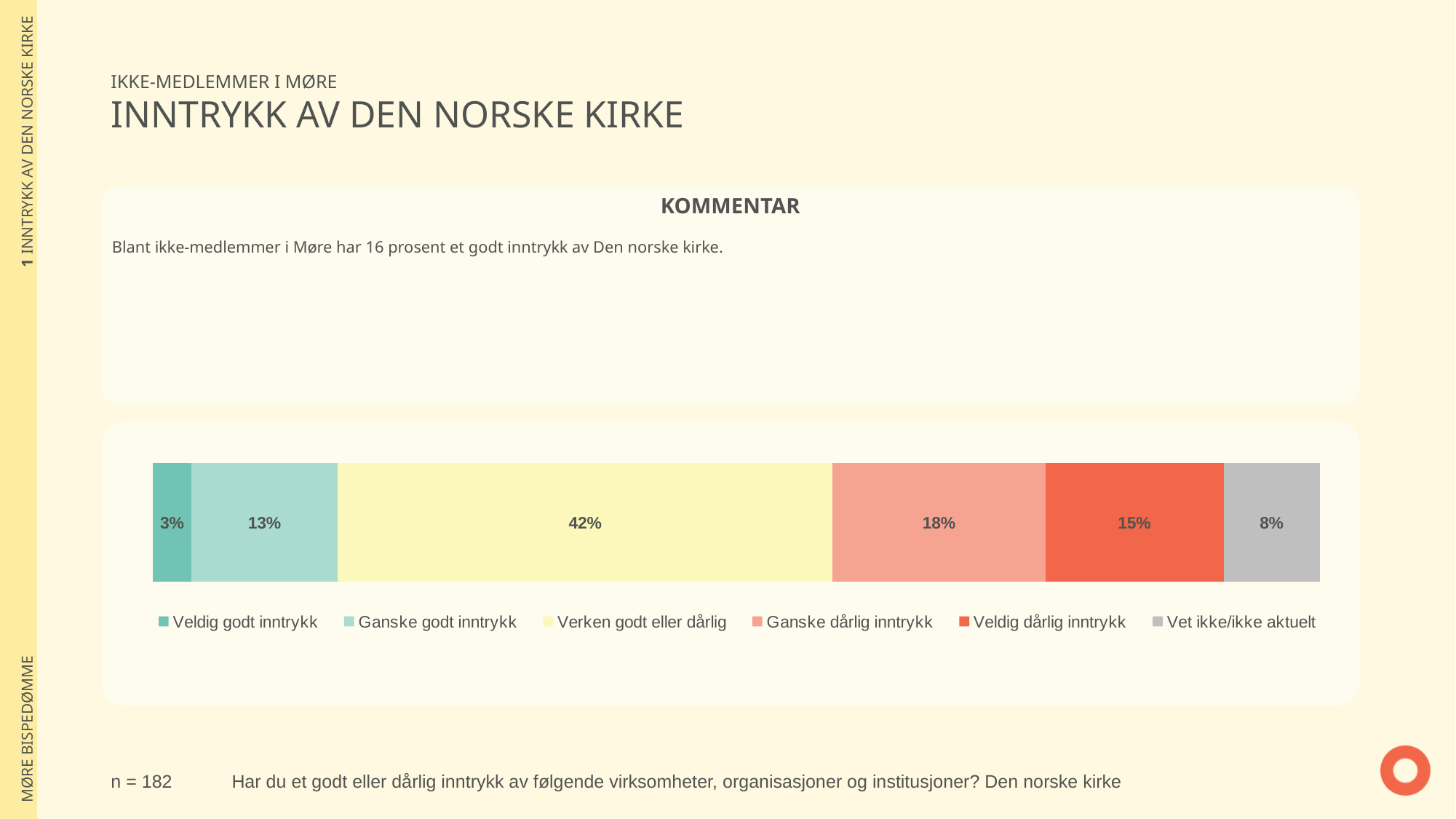
What is the value for "Ganske godt inntrykk"? 13% What is the value for "Vet ikke/ikke aktuelt"? 8% How many series does the legend list? 6 What colour is the segment for "Veldig dårlig inntrykk"? Red Which response category has the largest share? Verken godt eller dårlig Which response category has the smallest share? Veldig godt inntrykk What is the sample size (n) shown on the slide? 182 What kind of chart is shown on the slide? Stacked bar chart What percentage of respondents answered "Verken godt eller dårlig"? 42% Which is larger, "Ganske godt inntrykk" or "Ganske dårlig inntrykk"? Ganske dårlig inntrykk What is the combined share of "Veldig godt inntrykk" and "Ganske godt inntrykk"? 16% What is the difference between "Ganske dårlig inntrykk" and "Veldig dårlig inntrykk"? 3%